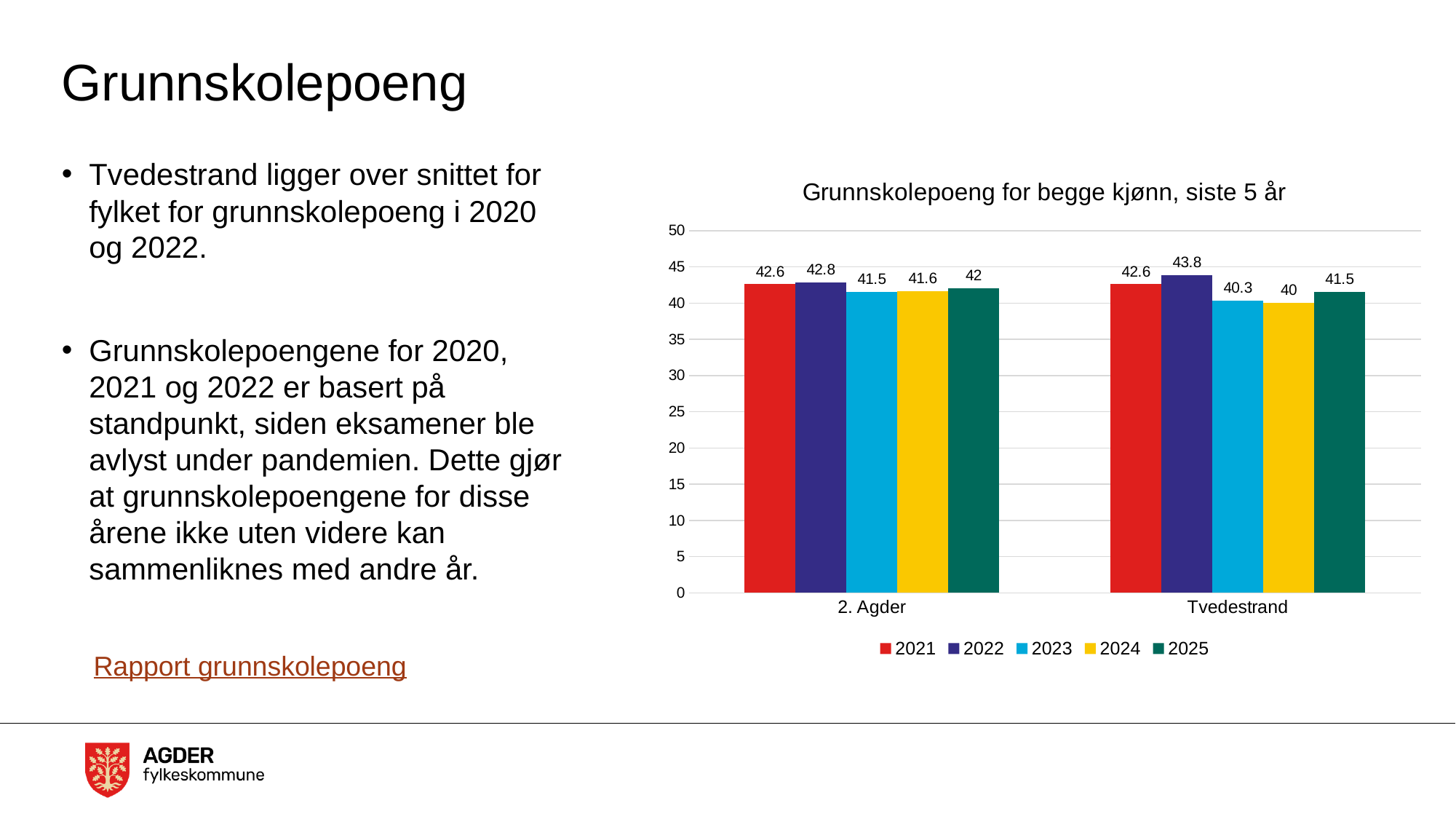
Which year has the highest value for Tvedestrand? 2022 What is the value for 2. Agder in 2022? 42.8 What is the title of the chart? Grunnskolepoeng for begge kjønn, siste 5 år What is the value for Tvedestrand in 2024? 40 Which is larger, the 2023 value for 2. Agder or the 2023 value for Tvedestrand? 2. Agder What is the difference between the 2022 values for Tvedestrand and 2. Agder? 1 What is the value for Tvedestrand in 2025? 41.5 How many series does the legend list? 5 Which year has the lowest value for 2. Agder? 2023 Which year has the lowest value for Tvedestrand? 2024 How many categories are shown on the x axis? 2 What kind of chart is shown on the slide? Bar chart